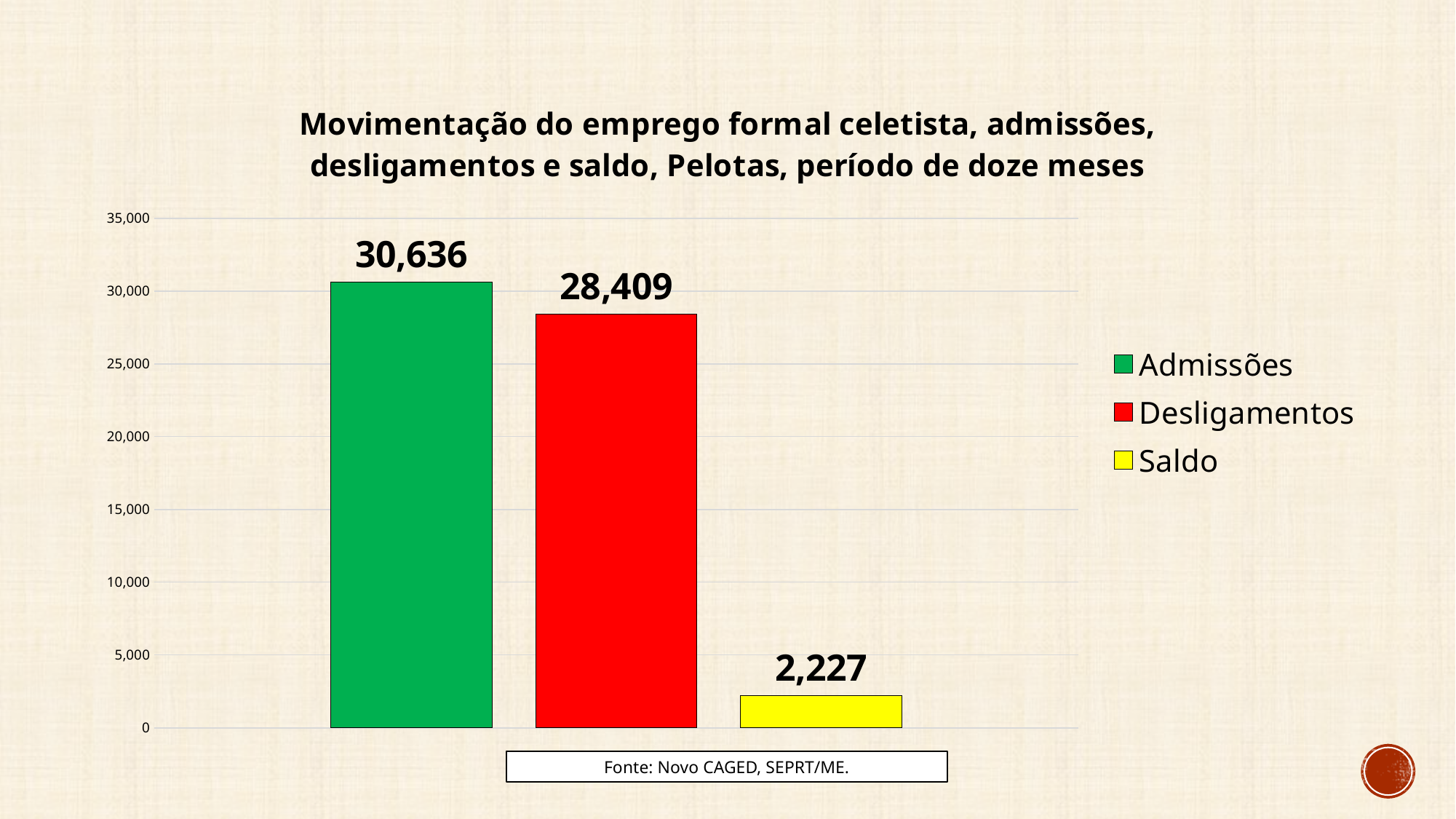
What source is cited below the chart? Novo CAGED, SEPRT/ME. What is the difference between Admissões and Desligamentos? 2,227 Which is larger, Desligamentos or Saldo? Desligamentos Is the value for Desligamentos greater or less than 25,000? greater What kind of chart is shown on the slide? bar chart Which series has the lowest value? Saldo Which series has the highest value? Admissões What colour is the bar for Saldo? yellow How many series does the legend list? 3 What is the value for Desligamentos? 28,409 What is the value for Saldo? 2,227 What is the value for Admissões? 30,636